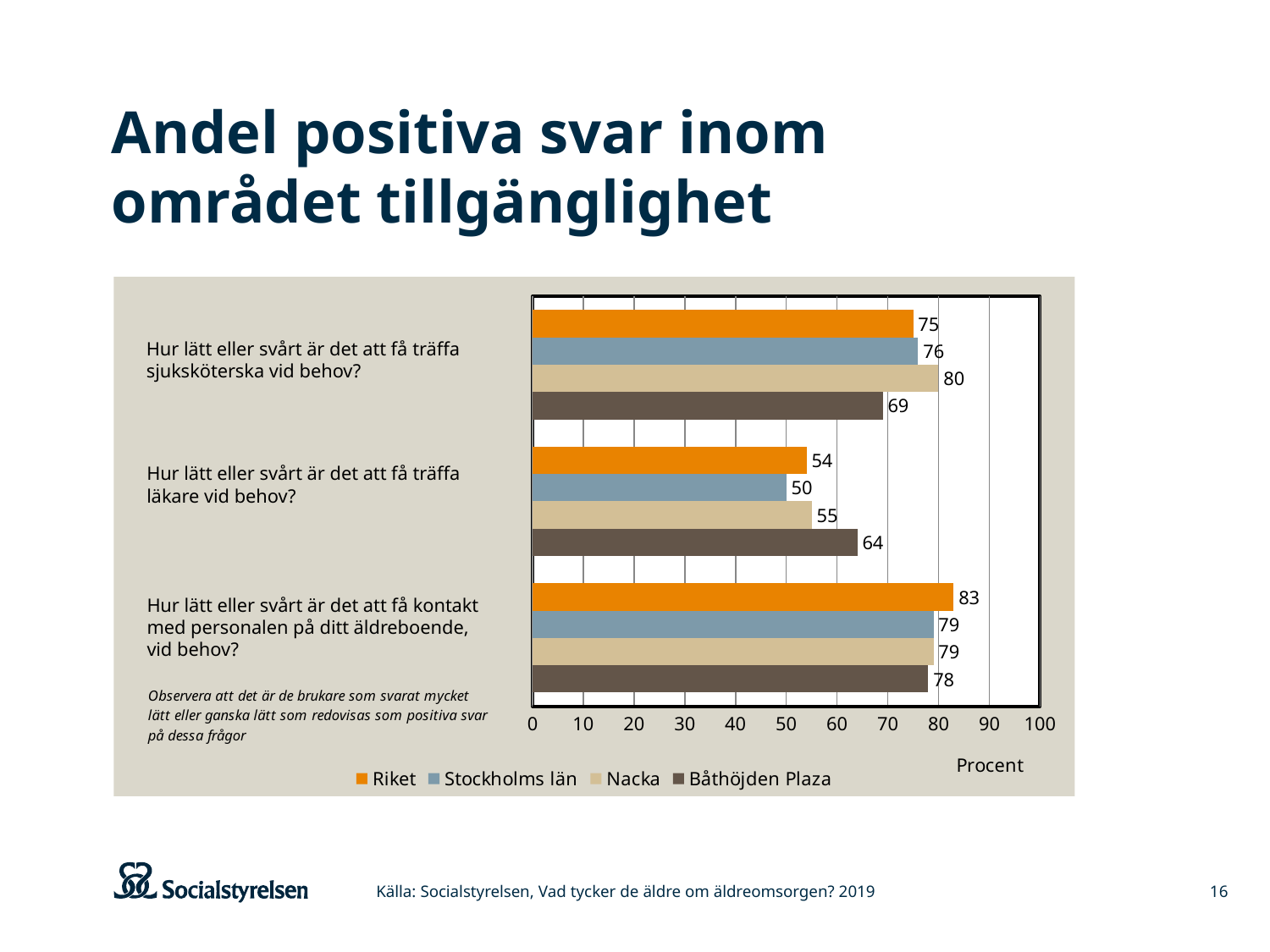
What is the value for Stockholms län on the question about getting in contact with staff at the care home? 79 How many series does the legend list? 4 Which series has the lowest value on the question about meeting a doctor (läkare) when needed? Stockholms län What is the difference between the Nacka and Båthöjden Plaza values on the question about meeting a nurse (sjuksköterska)? 11 What is the label on the horizontal axis of the chart? Procent How many questions (categories) are shown on the chart? 3 Which series has the highest value on the question about meeting a nurse (sjuksköterska) when needed? Nacka What is the value for Nacka on the question about meeting a nurse (sjuksköterska) when needed? 80 What is the value for Riket on the question about getting in contact with staff at the care home? 83 Which is larger on the question about meeting a doctor (läkare): the value for Riket or for Båthöjden Plaza? Båthöjden Plaza What type of chart is shown on the slide? bar chart What is the value for Båthöjden Plaza on the question about meeting a doctor (läkare) when needed? 64